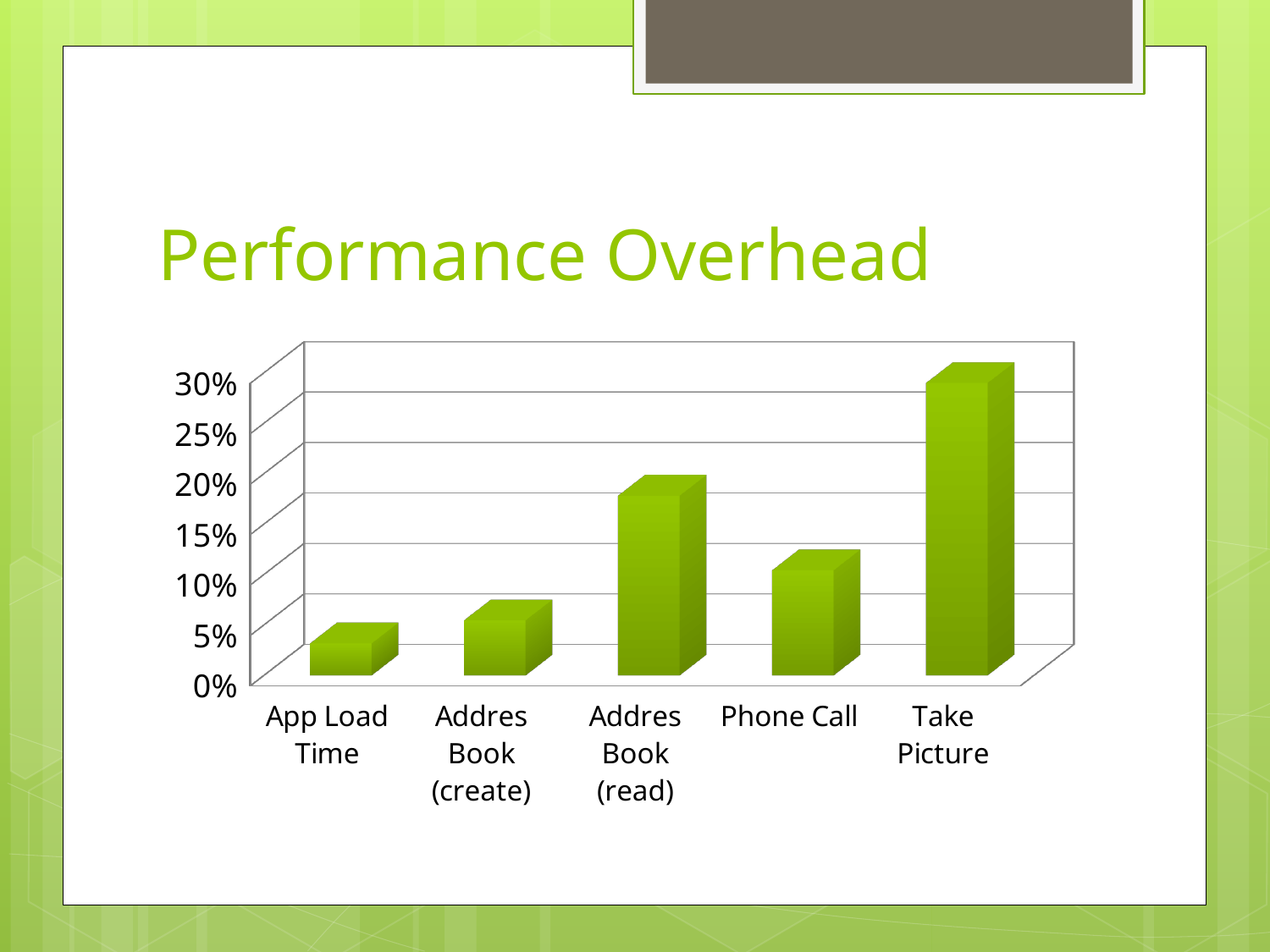
How many categories are shown on the x axis? 5 Is the value for Addres Book (read) greater or less than 15%? greater Which is larger, the value for Addres Book (create) or the value for Take Picture? Take Picture Which category has the lowest value? App Load Time What kind of chart is shown on the slide? bar chart Which is larger, the value for Addres Book (read) or the value for Phone Call? Addres Book (read) Is the value for Addres Book (create) greater or less than 10%? less What is the title of the chart? Performance Overhead Is the value for Take Picture greater or less than 25%? greater Which category has the highest value? Take Picture